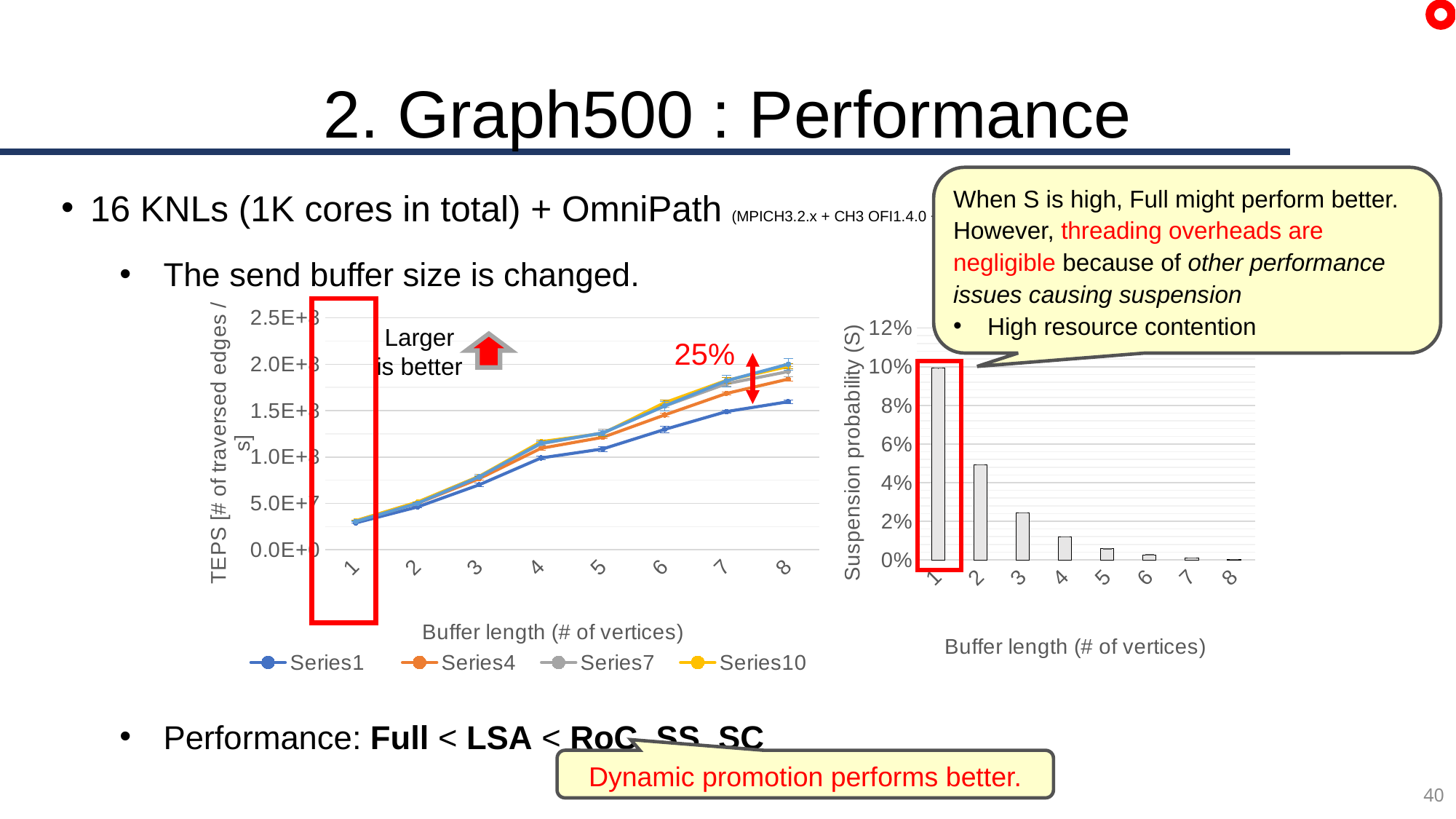
In the right chart, which buffer length has the highest suspension probability? 1 What kind of chart is the right chart (Suspension probability vs buffer length)? bar chart In the left chart, do the TEPS values rise or fall as buffer length increases? rise In the left chart, is the value of Series1 at buffer length 8 greater or less than 1.5E+8? greater In the right chart, do the values rise or fall as buffer length increases? fall In the left chart, at buffer length 8, which is larger: Series1 or Series4? Series4 In the right chart, which buffer length has the lowest suspension probability? 8 What kind of chart is the left chart (TEPS vs buffer length)? line chart In the left chart, how many buffer length values are plotted along the x axis? 8 In the left chart, how many series does the legend list? 4 In the right chart, how many bars are there? 8 In the right chart, is the suspension probability for buffer length 2 greater or less than 6%? less